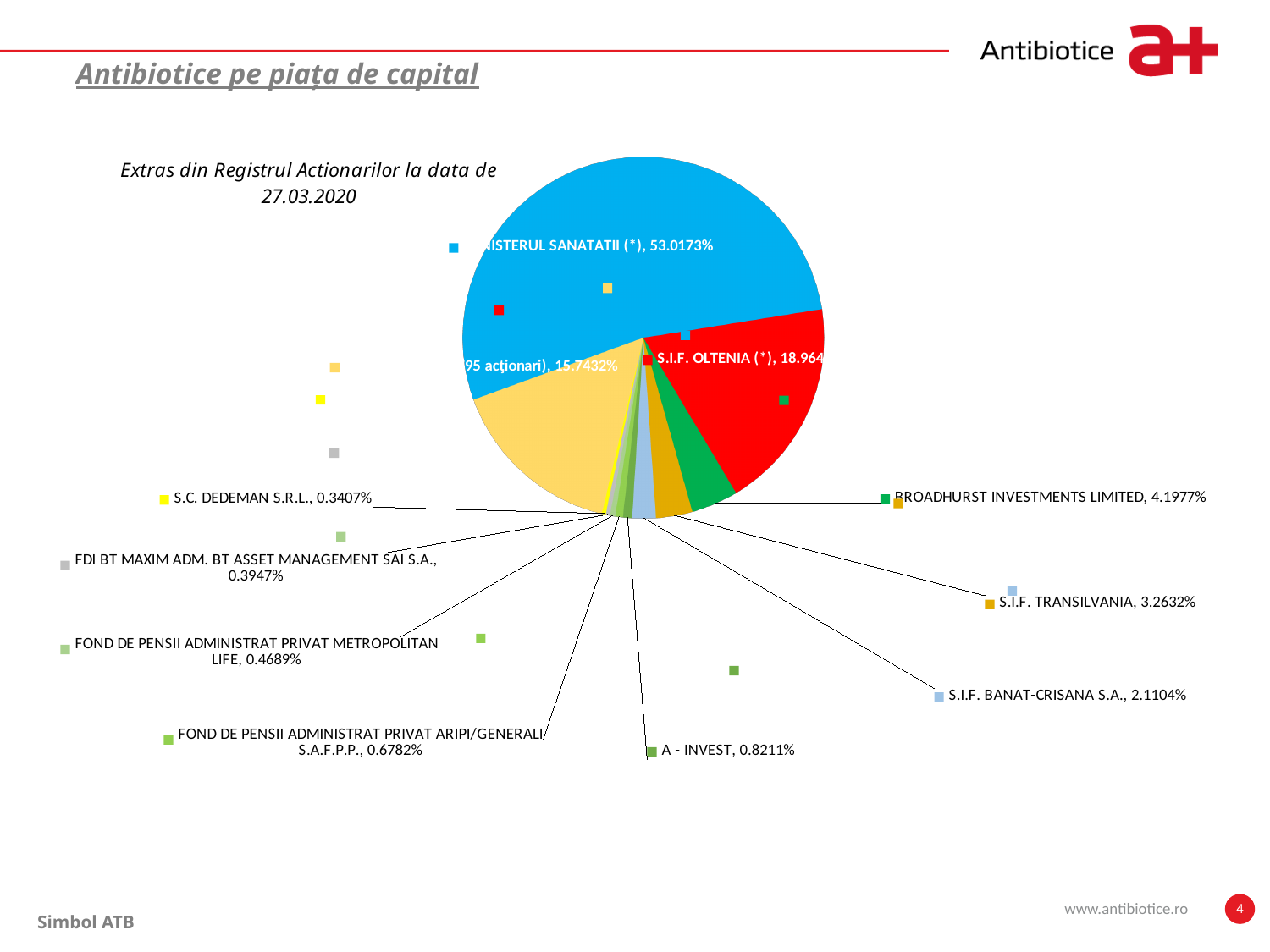
Which shareholder holds the largest slice of the pie? MINISTERUL SANATATII (*) Which is larger, the share of S.I.F. TRANSILVANIA or the share of S.I.F. BANAT-CRISANA S.A.? S.I.F. TRANSILVANIA What kind of chart is shown on the slide? pie chart What percentage is labelled for S.I.F. BANAT-CRISANA S.A.? 2.1104% What is the value shown for S.I.F. TRANSILVANIA? 3.2632% What percentage is shown for FOND DE PENSII ADMINISTRAT PRIVAT METROPOLITAN LIFE? 0.4689% What share is labelled for MINISTERUL SANATATII (*)? 53.0173% What share does BROADHURST INVESTMENTS LIMITED hold according to the pie chart? 4.1977% What is the difference between the shares of S.I.F. TRANSILVANIA and S.I.F. BANAT-CRISANA S.A.? 1.1528% What share is shown for A - INVEST? 0.8211% What is the value for S.C. DEDEMAN S.R.L.? 0.3407% As of what date is the shareholder register extract shown on the slide? 27.03.2020